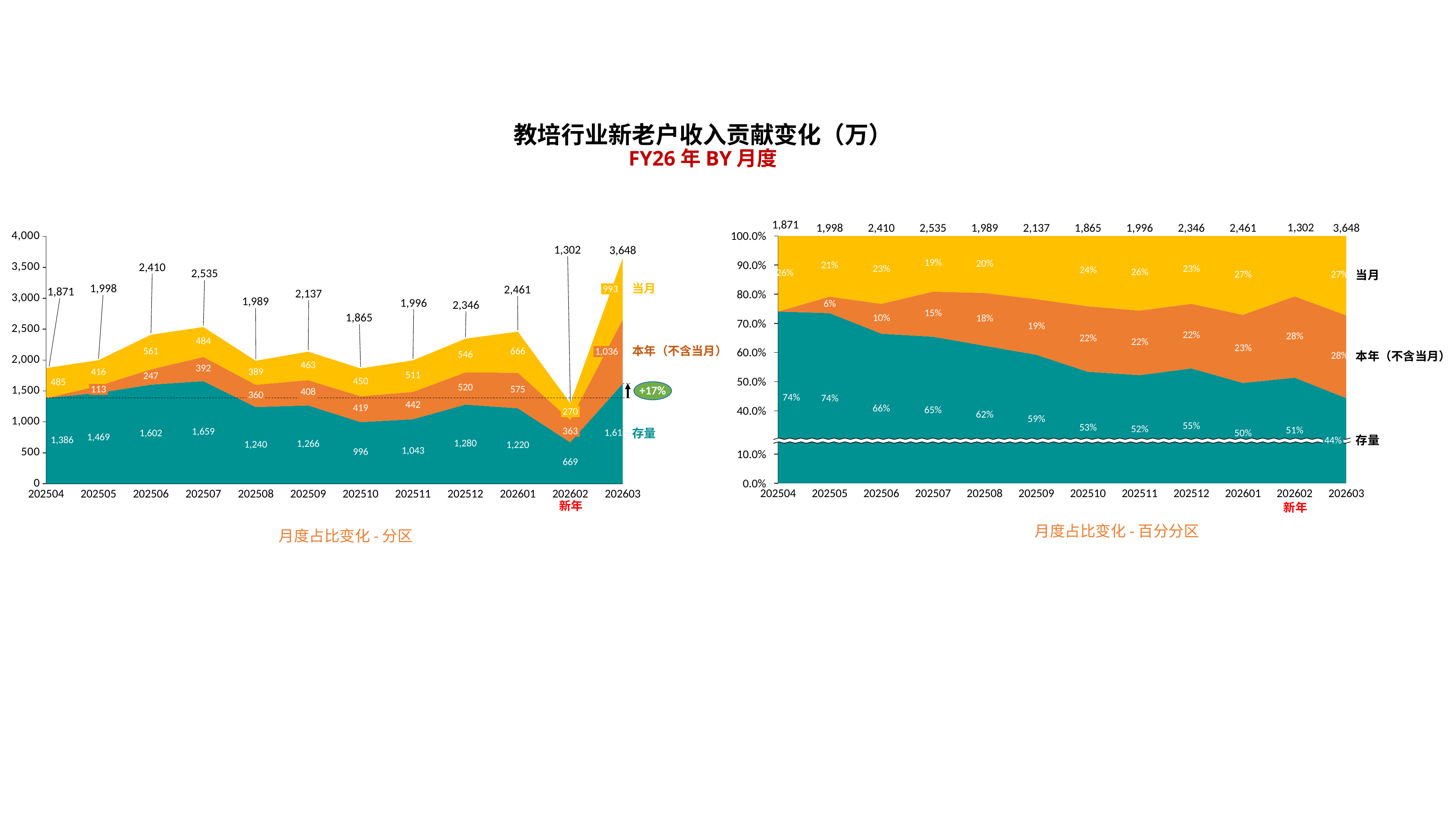
What kind of chart is the left chart (月度占比变化 - 分区)? Stacked area chart How many months are shown on the x axis of the right chart (月度占比变化 - 百分分区)? 12 In the right chart (月度占比变化 - 百分分区), what is the 存量 share for 202603? 44% In the left chart (月度占比变化 - 分区), what is the difference between the totals for 202603 and 202602? 2,346 In the right chart (月度占比变化 - 百分分区), does the 存量 share generally rise or fall from 202504 to 202603? fall In the left chart (月度占比变化 - 分区), what is the total value for 202603? 3,648 In the left chart (月度占比变化 - 分区), which month has the highest total? 202603 In the left chart (月度占比变化 - 分区), what is the 存量 value for 202602? 669 In the left chart (月度占比变化 - 分区), which month has the lowest total? 202602 In the left chart (月度占比变化 - 分区), which month has the larger 存量 value, 202506 or 202507? 202507 In the left chart (月度占比变化 - 分区), what is the 当月 value for 202601? 666 In the right chart (月度占比变化 - 百分分区), what is the 本年（不含当月） share for 202602? 28%